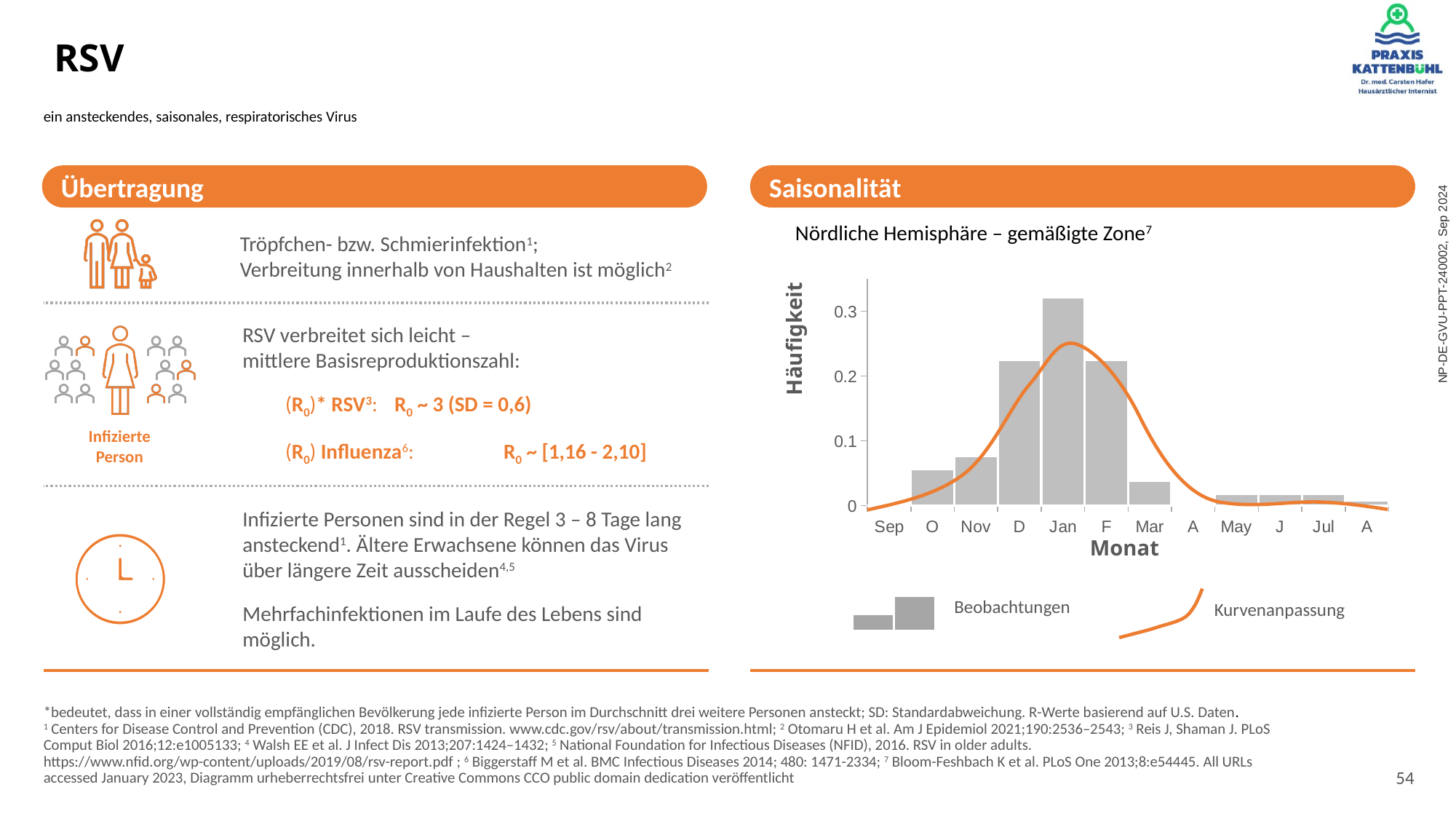
What kind of chart is shown under Saisonalität? bar chart with a fitted curve What is the title above the chart? Nördliche Hemisphäre – gemäßigte Zone What are the two legend entries of the chart? Beobachtungen and Kurvenanpassung Is the value for Mar greater or less than 0.1? less Which is larger, the value for Jan or the value for D? Jan Is the value for D greater or less than 0.2? greater How many months are shown on the x axis of the chart? 12 Which is larger, the value for Nov or the value for Sep? Nov Do the bar values rise or fall from Sep to Jan? rise Is the value for Jan greater or less than 0.3? greater Which month has the highest Häufigkeit in the chart? Jan